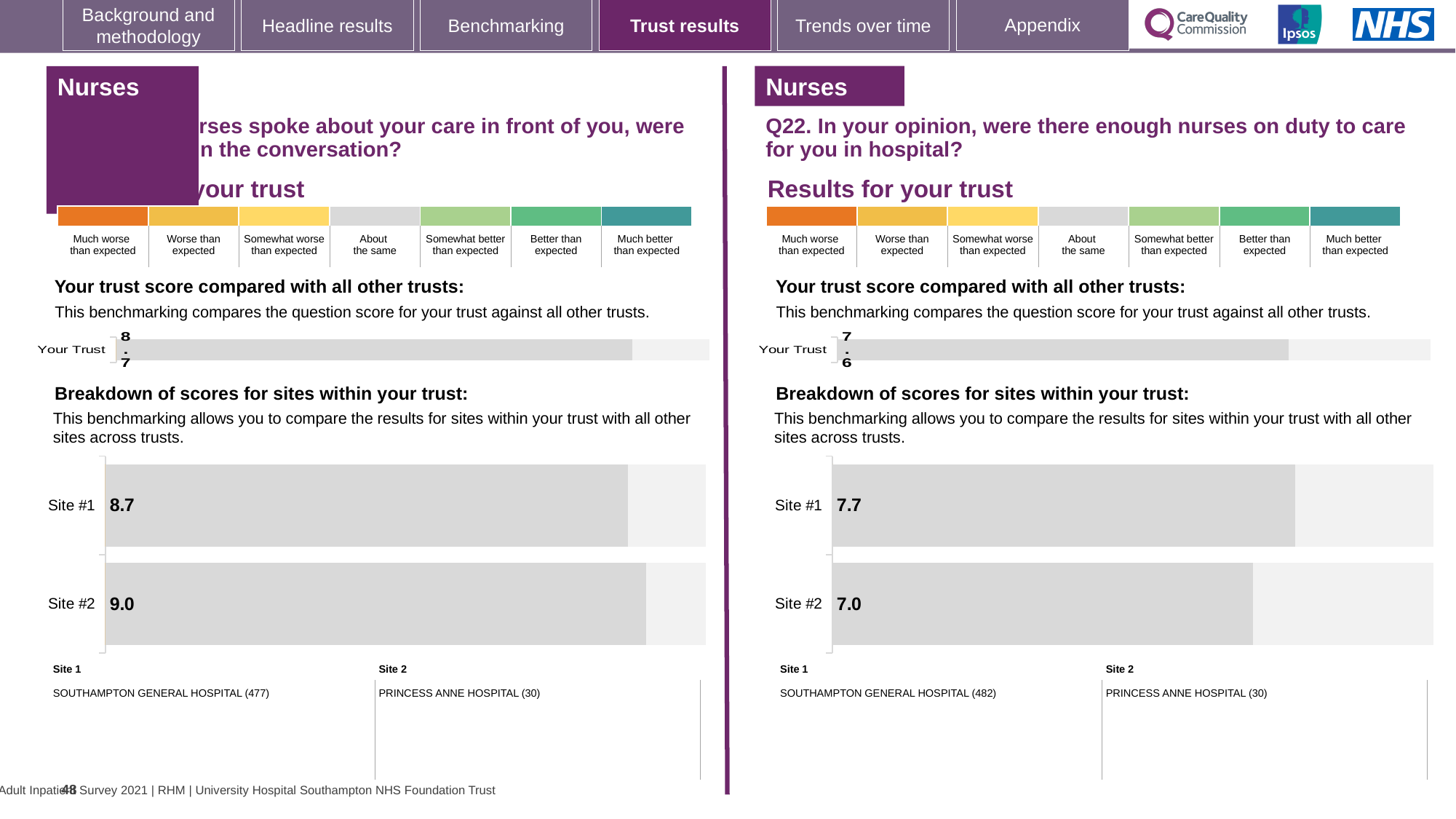
On the right half of the slide (Q22), what is the score shown for Site #1 in the breakdown of scores for sites within your trust? 7.7 On the left half of the slide, what is the value shown for Your Trust in the trust score chart? 8.7 On the left half of the slide, what is the difference between the Site #2 and Site #1 scores? 0.3 On the right half of the slide (Q22), what is the value shown for Your Trust in the trust score chart? 7.6 How many sites are shown in the breakdown of scores chart on the right half of the slide (Q22)? 2 On the right half of the slide (Q22), which site has the lower score in the breakdown of scores for sites within your trust? Site #2 On the right half of the slide (Q22), what is the score shown for Site #2 in the breakdown of scores for sites within your trust? 7.0 What type of chart is used for the breakdown of scores for sites within your trust on the left half of the slide? Bar chart On the right half of the slide (Q22), what is the difference between the Site #1 and Site #2 scores? 0.7 On the left half of the slide, what is the score shown for Site #2 in the breakdown of scores for sites within your trust? 9.0 On the left half of the slide, what is the score shown for Site #1 in the breakdown of scores for sites within your trust? 8.7 On the left half of the slide, which site has the higher score in the breakdown of scores for sites within your trust? Site #2